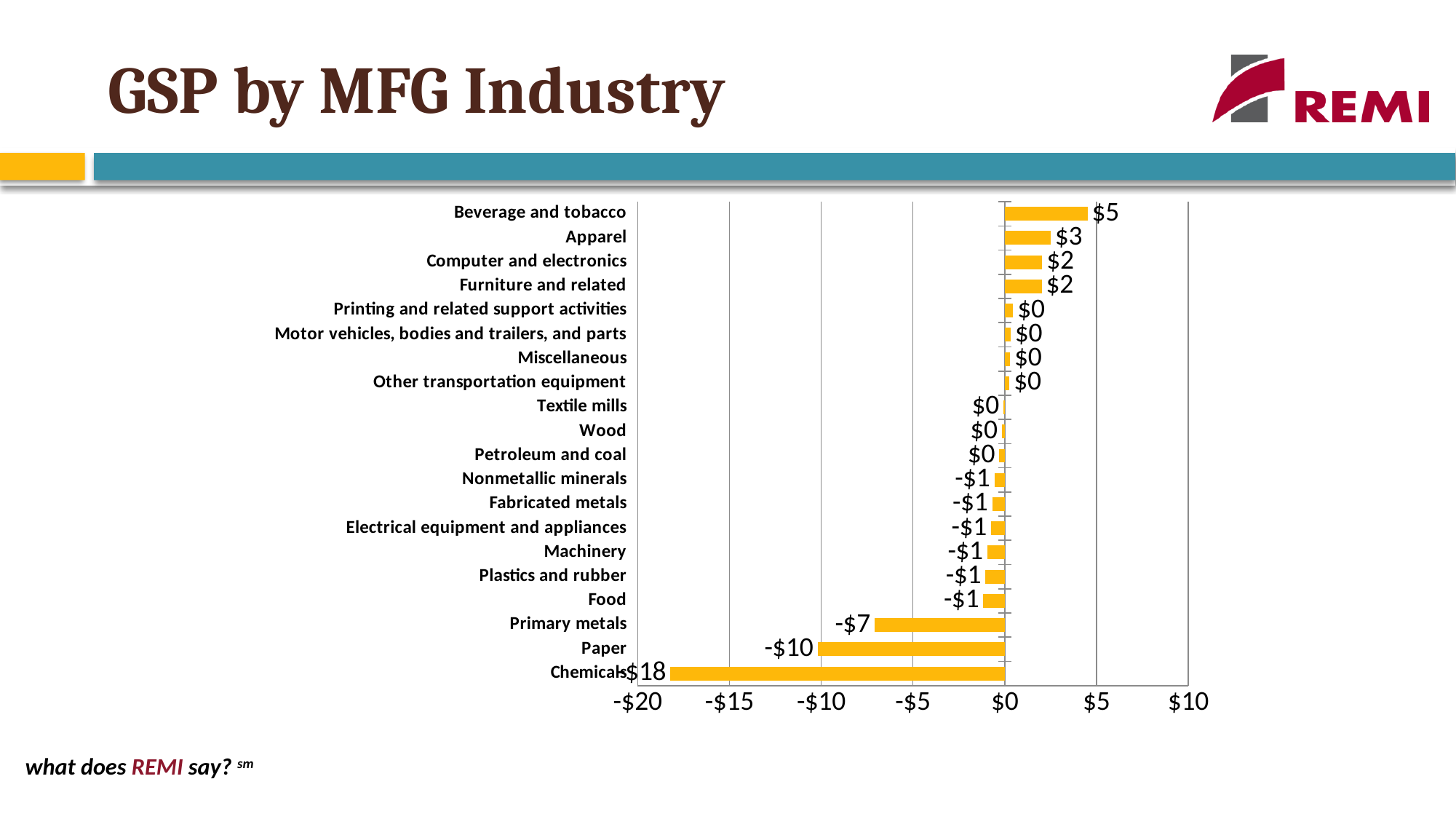
What is the title of the slide? GSP by MFG Industry Is the value for Chemicals greater or less than -$15? less What is the value for Paper? -$10 What kind of chart is shown on the slide? bar chart What is the value for Beverage and tobacco? $5 What is the value for Apparel? $3 Which industry has the lowest value? Chemicals What is the value for Primary metals? -$7 How many industries are shown on the chart? 20 What is the difference between the values for Beverage and tobacco and Apparel? $2 Which has a larger value, Paper or Primary metals? Primary metals Which industry has the highest value? Beverage and tobacco